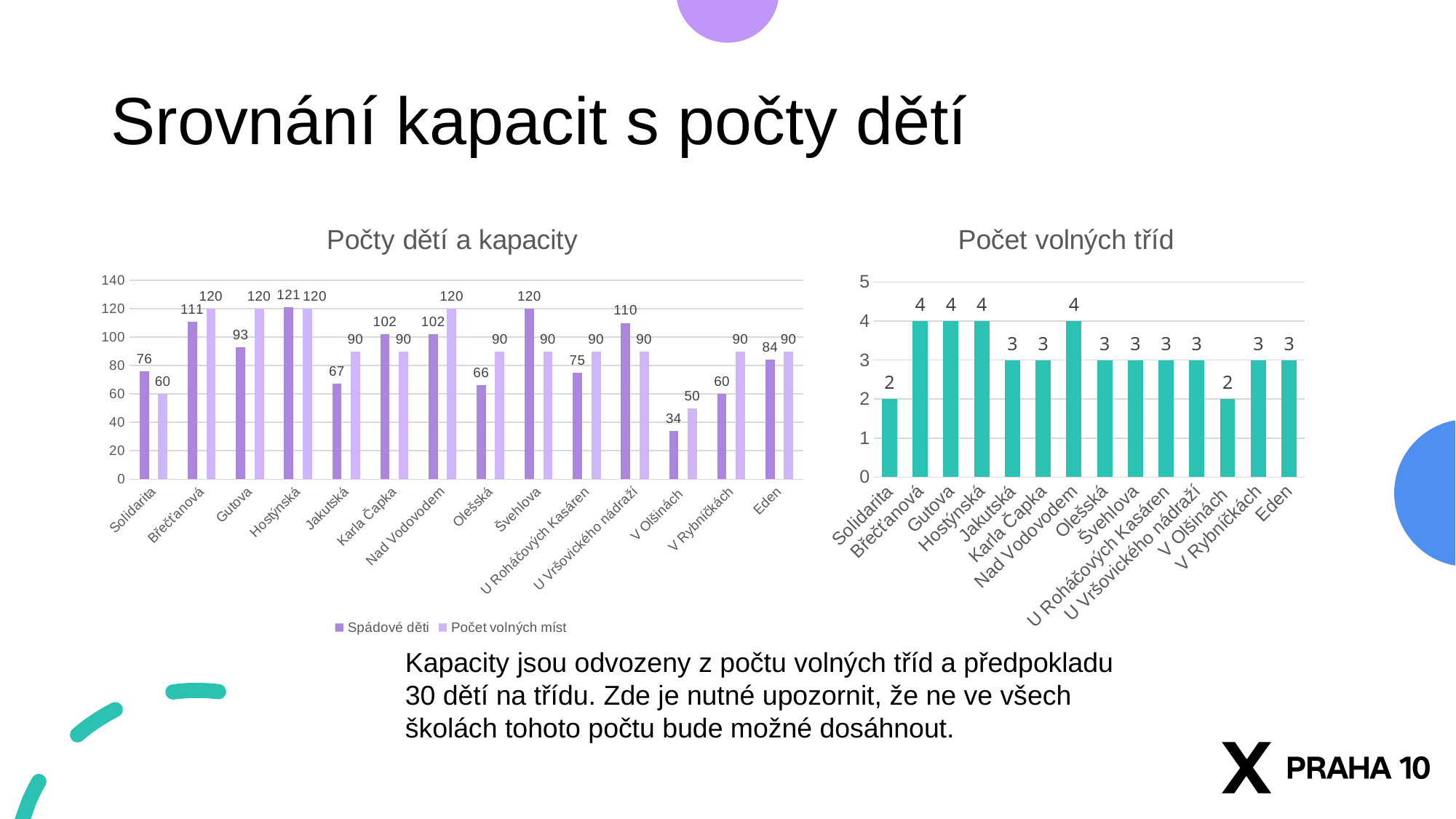
What kind of chart is 'Počet volných tříd'? Bar chart In the chart 'Počty dětí a kapacity', what is the value of Počet volných míst for V Olšinách? 50 In the chart 'Počty dětí a kapacity', which is larger for Gutova: Spádové děti or Počet volných míst? Počet volných míst In the chart 'Počty dětí a kapacity', which category has the lowest value of Spádové děti? V Olšinách In the chart 'Počty dětí a kapacity', which category has the highest value of Spádové děti? Hostýnská In the chart 'Počet volných tříd', what is the value for Nad Vodovodem? 4 How many categories are shown in the chart 'Počet volných tříd'? 14 In the chart 'Počty dětí a kapacity', what is the difference between Spádové děti and Počet volných míst for Švehlova? 30 In the chart 'Počty dětí a kapacity', what is the value of Spádové děti for Solidarita? 76 How many series does the legend of the chart 'Počty dětí a kapacity' list? 2 In the chart 'Počet volných tříd', what is the difference between Břečťanová and Solidarita? 2 In the chart 'Počet volných tříd', which categories have the lowest value? Solidarita and V Olšinách